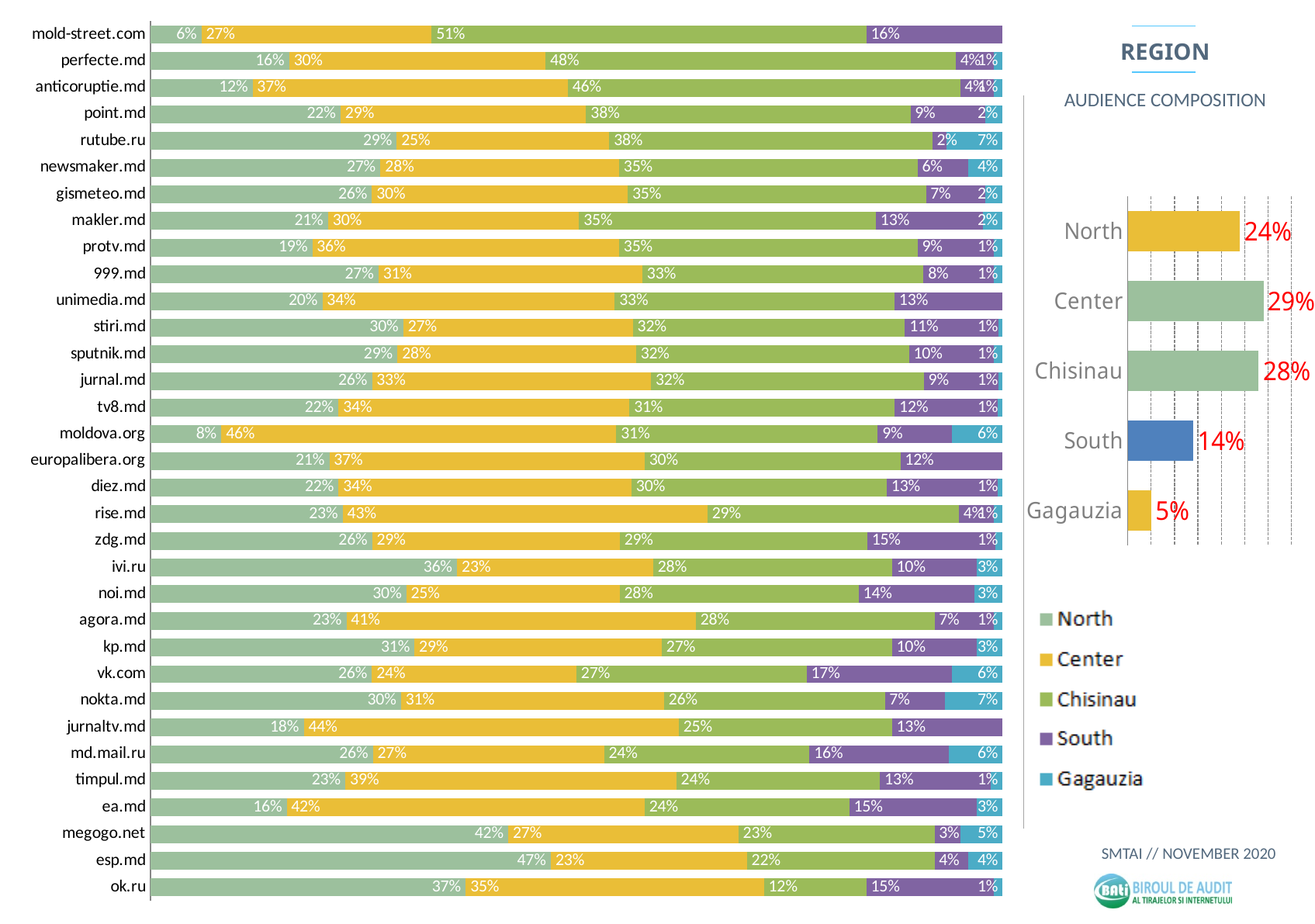
How many websites are listed in the stacked bar chart on the left? 33 In the REGION audience composition chart on the right, what is the value for Center? 29% In the stacked bar chart on the left, what is the South share for vk.com? 17% In the REGION audience composition chart on the right, which region has the highest value? Center In the REGION audience composition chart on the right, what is the difference between the values for North and South? 10% What kind of chart is the large chart on the left of the slide? Stacked bar chart In the REGION audience composition chart on the right, which region has the lowest value? Gagauzia In the stacked bar chart on the left, which has the larger Center share, moldova.org or jurnaltv.md? moldova.org In the stacked bar chart on the left, what is the North share for esp.md? 47% In the stacked bar chart on the left, what is the Chisinau share for mold-street.com? 51% How many regions are shown in the REGION audience composition chart on the right? 5 How many series does the legend of the stacked bar chart on the left list? 5